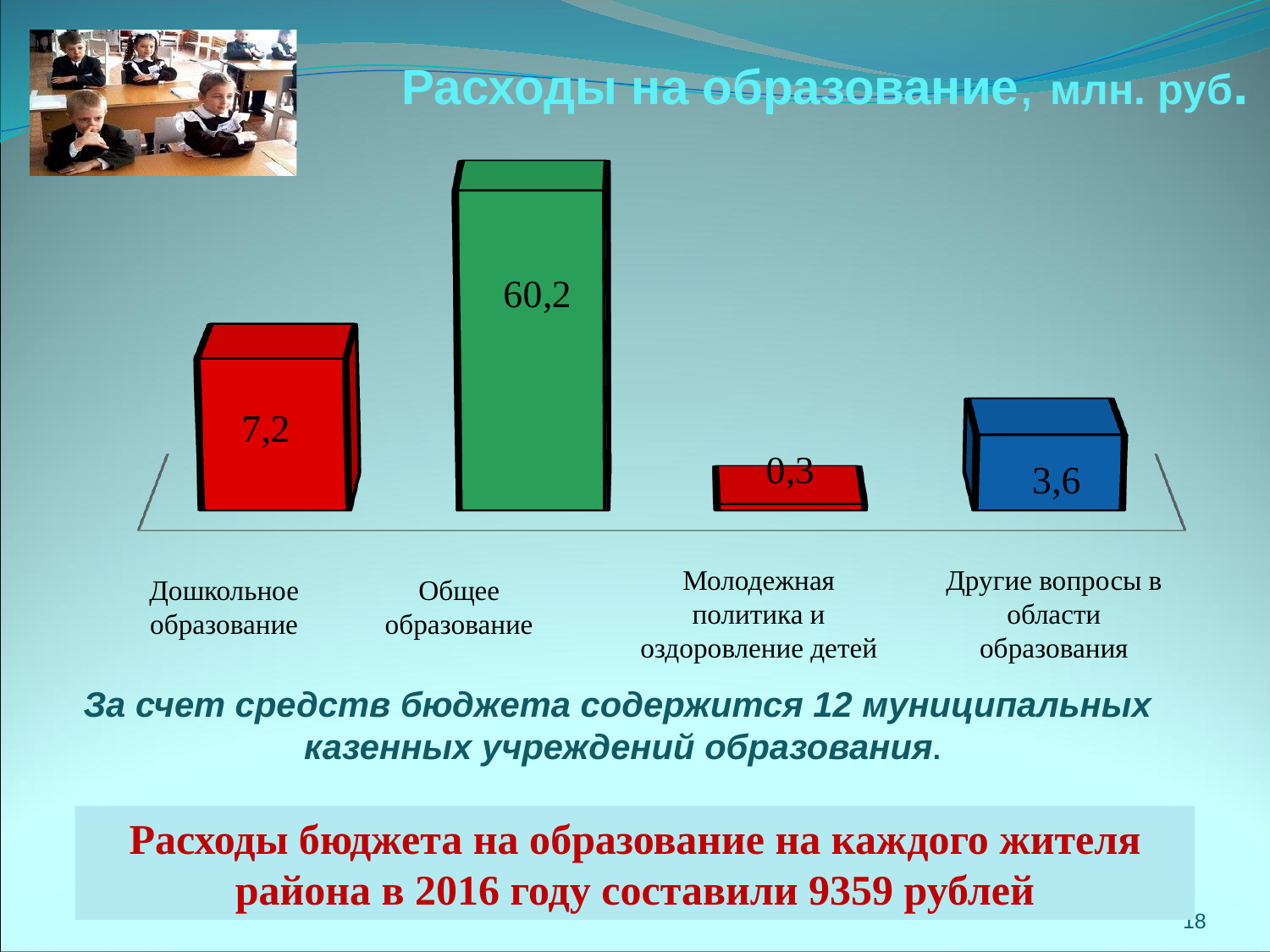
Which category has the highest value? Общее образование Which is larger, the value for Дошкольное образование or the value for Другие вопросы в области образования? Дошкольное образование Which category has the lowest value? Молодежная политика и оздоровление детей How many categories are shown in the chart? 4 What is the value for Общее образование? 60,2 What is the value for Дошкольное образование? 7,2 What is the difference between the values for Общее образование and Дошкольное образование? 53 What is the value for Молодежная политика и оздоровление детей? 0,3 What kind of chart is shown on the slide? Bar chart What is the title of the chart? Расходы на образование, млн. руб. What is the value for Другие вопросы в области образования? 3,6 What is the difference between the values for Дошкольное образование and Другие вопросы в области образования? 3,6